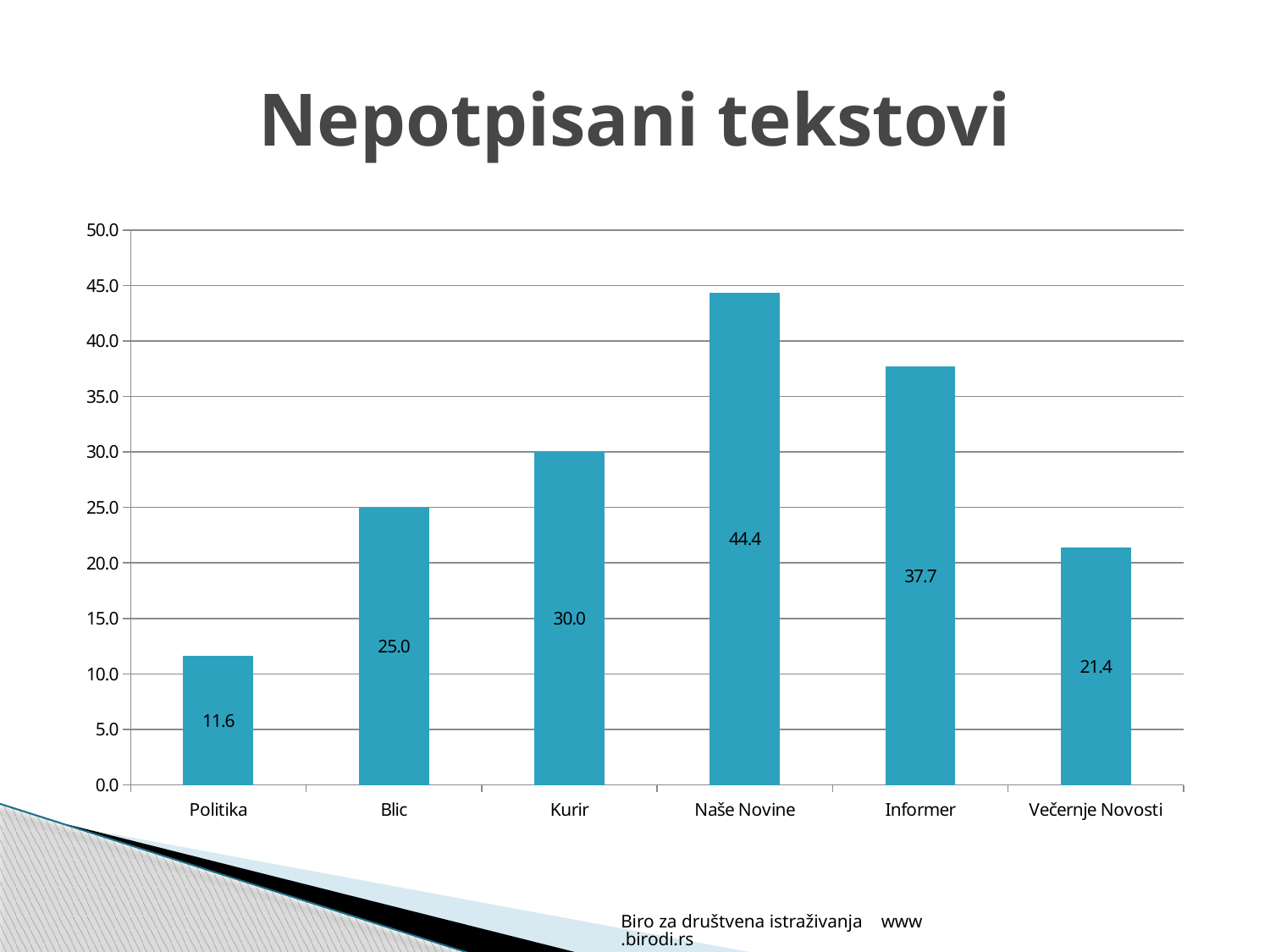
Which category has the highest value? Naše Novine What is the difference between the values for Naše Novine and Informer? 6.7 What kind of chart is shown on the slide? bar chart Is the value for Blic greater or less than 30.0? less What is the value for Naše Novine? 44.4 What is the difference between the values for Kurir and Blic? 5.0 Which is larger, the value for Informer or the value for Kurir? Informer How many categories are shown on the x axis? 6 What is the value for Politika? 11.6 What is the value for Večernje Novosti? 21.4 Which category has the lowest value? Politika What is the title of the slide? Nepotpisani tekstovi